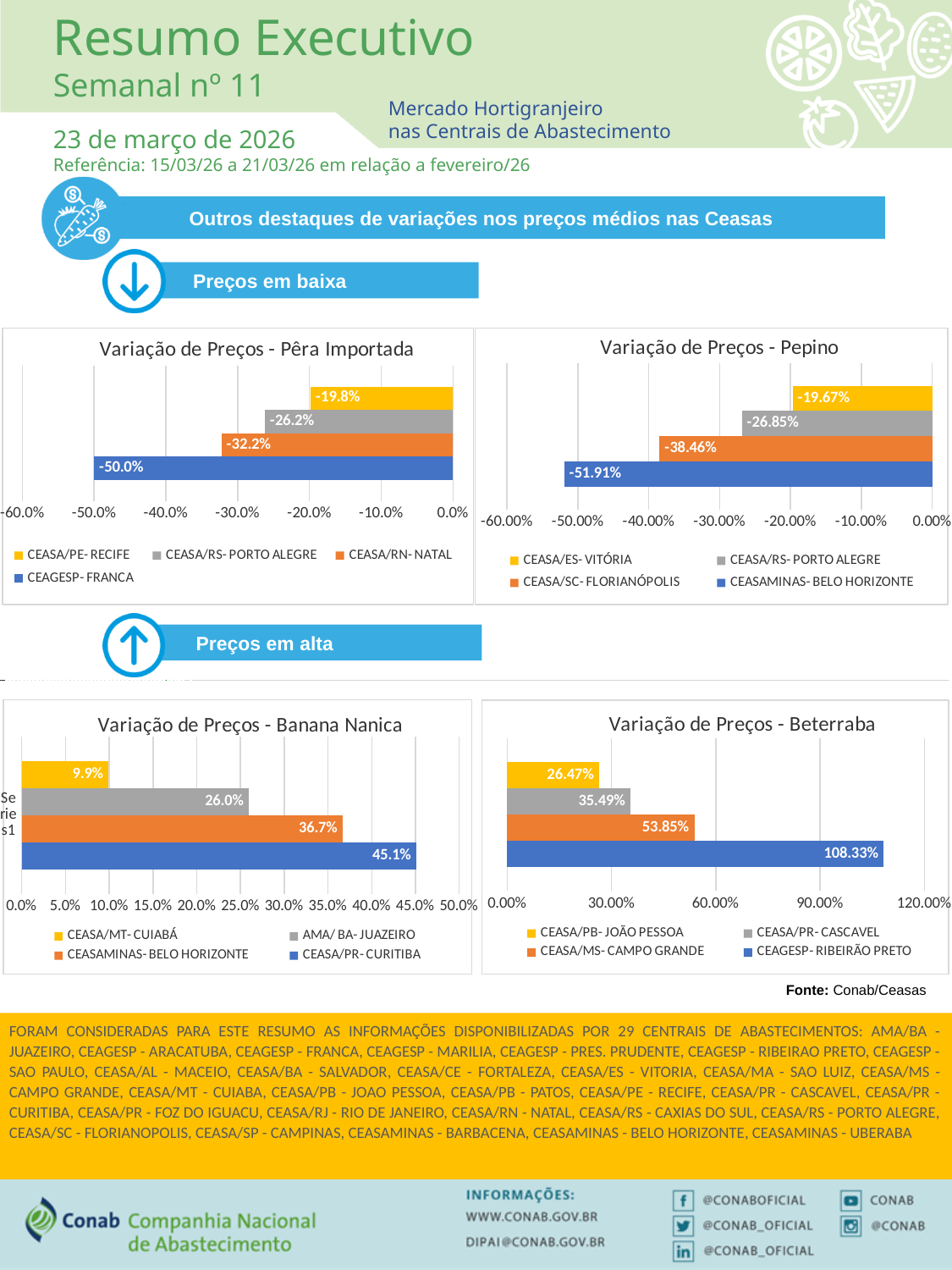
In the 'Variação de Preços - Pêra Importada' chart, what is the value for CEASA/RS-PORTO ALEGRE? -26.2% In the 'Variação de Preços - Pepino' chart, which series has the largest price decrease? CEASAMINAS-BELO HORIZONTE In the 'Variação de Preços - Beterraba' chart, what is the difference between the values for CEASA/MS-CAMPO GRANDE and CEASA/PB-JOÃO PESSOA? 27.38% In the 'Variação de Preços - Pêra Importada' chart, what is the value for CEAGESP-FRANCA? -50.0% In the 'Variação de Preços - Pepino' chart, what is the value for CEASA/SC-FLORIANÓPOLIS? -38.46% In the 'Variação de Preços - Pêra Importada' chart, what colour is the bar for CEASA/RN-NATAL? Orange In the 'Variação de Preços - Beterraba' chart, what is the value for CEAGESP-RIBEIRÃO PRETO? 108.33% In the 'Variação de Preços - Beterraba' chart, which is larger: the value for CEASA/PR-CASCAVEL or CEASA/MS-CAMPO GRANDE? CEASA/MS-CAMPO GRANDE What type of chart is 'Variação de Preços - Banana Nanica'? Bar chart In the 'Variação de Preços - Banana Nanica' chart, which series has the lowest value? CEASA/MT-CUIABÁ In the 'Variação de Preços - Banana Nanica' chart, what is the value for CEASA/PR-CURITIBA? 45.1% How many series does the legend of the 'Variação de Preços - Pepino' chart list? 4